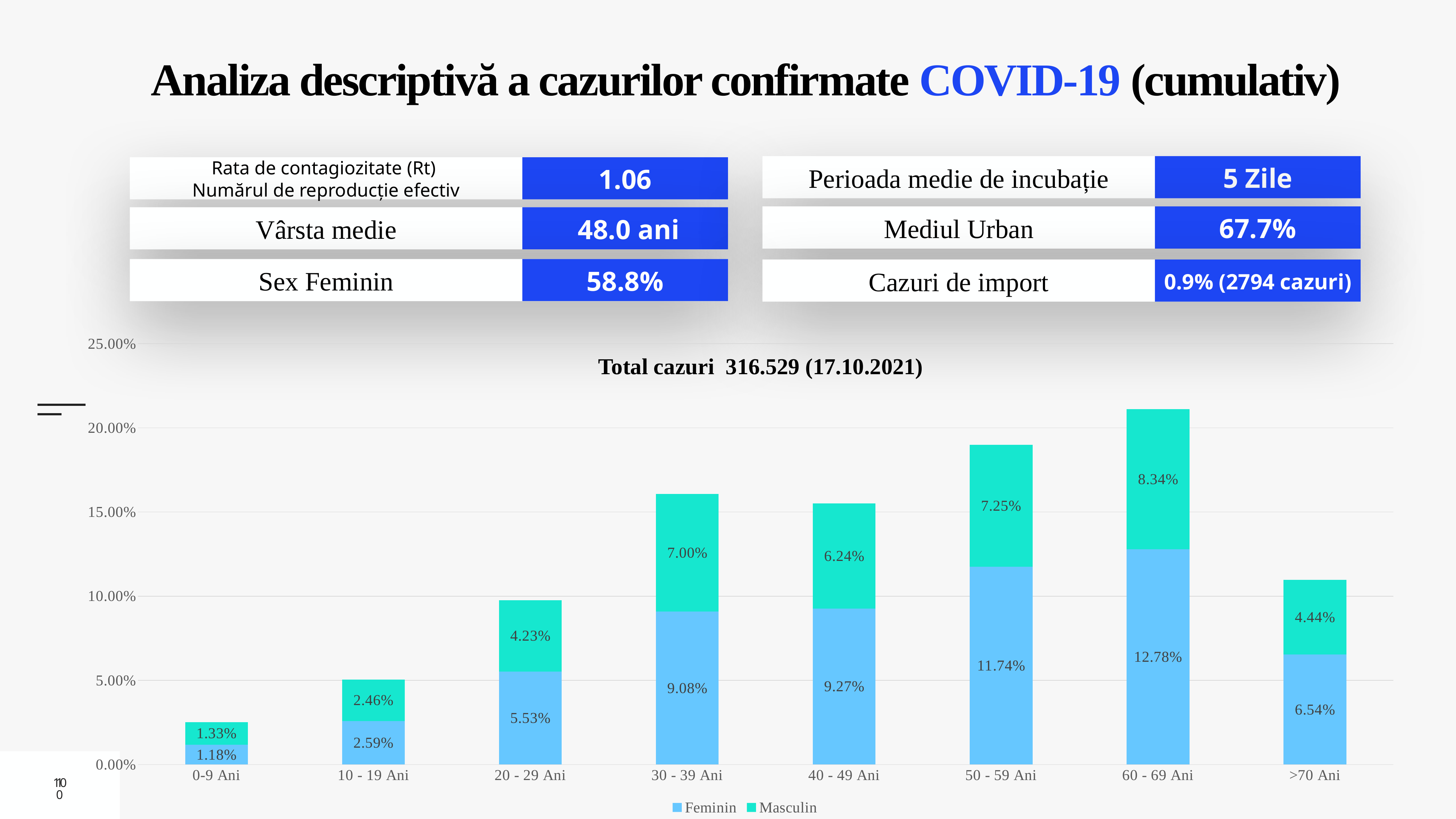
How many age categories are shown on the x axis of the chart? 8 Which age category has the highest Masculin value? 60 - 69 Ani How many series does the chart legend list? 2 What is the Masculin value for the 30 - 39 Ani category? 7.00% What type of chart is shown on the slide? stacked bar chart What is the Feminin value for the 60 - 69 Ani category? 12.78% What is the difference between the Feminin and Masculin values for the 50 - 59 Ani category? 4.49% What is the total of the stacked bar for the 60 - 69 Ani category? 21.12% Which is larger for the 40 - 49 Ani category, the Feminin value or the Masculin value? Feminin Which age category has the lowest Feminin value? 0-9 Ani What is the Feminin value for the >70 Ani category? 6.54% What is the title shown above the chart? Total cazuri 316.529 (17.10.2021)